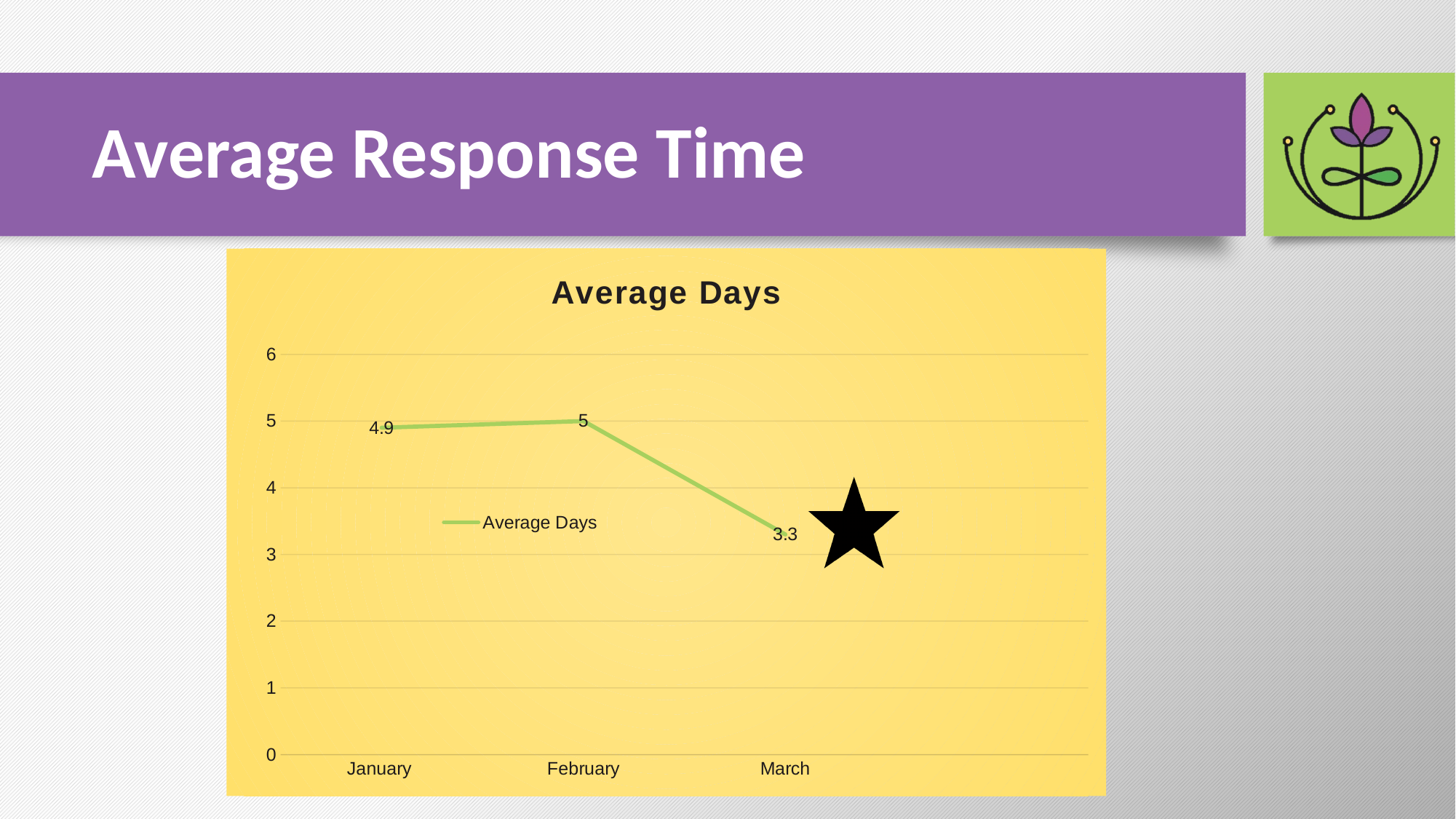
Which month has the lowest value? March How many months are plotted on the chart? 3 What is the value for January? 4.9 What is the difference between the January and March values? 1.6 What is the value for March? 3.3 What is the difference between the February and March values? 1.7 Which month has the highest value? February How many series does the legend list? 1 What kind of chart is shown? line chart What is the title of the chart? Average Days Which is larger, the value for January or the value for March? January What is the value for February? 5